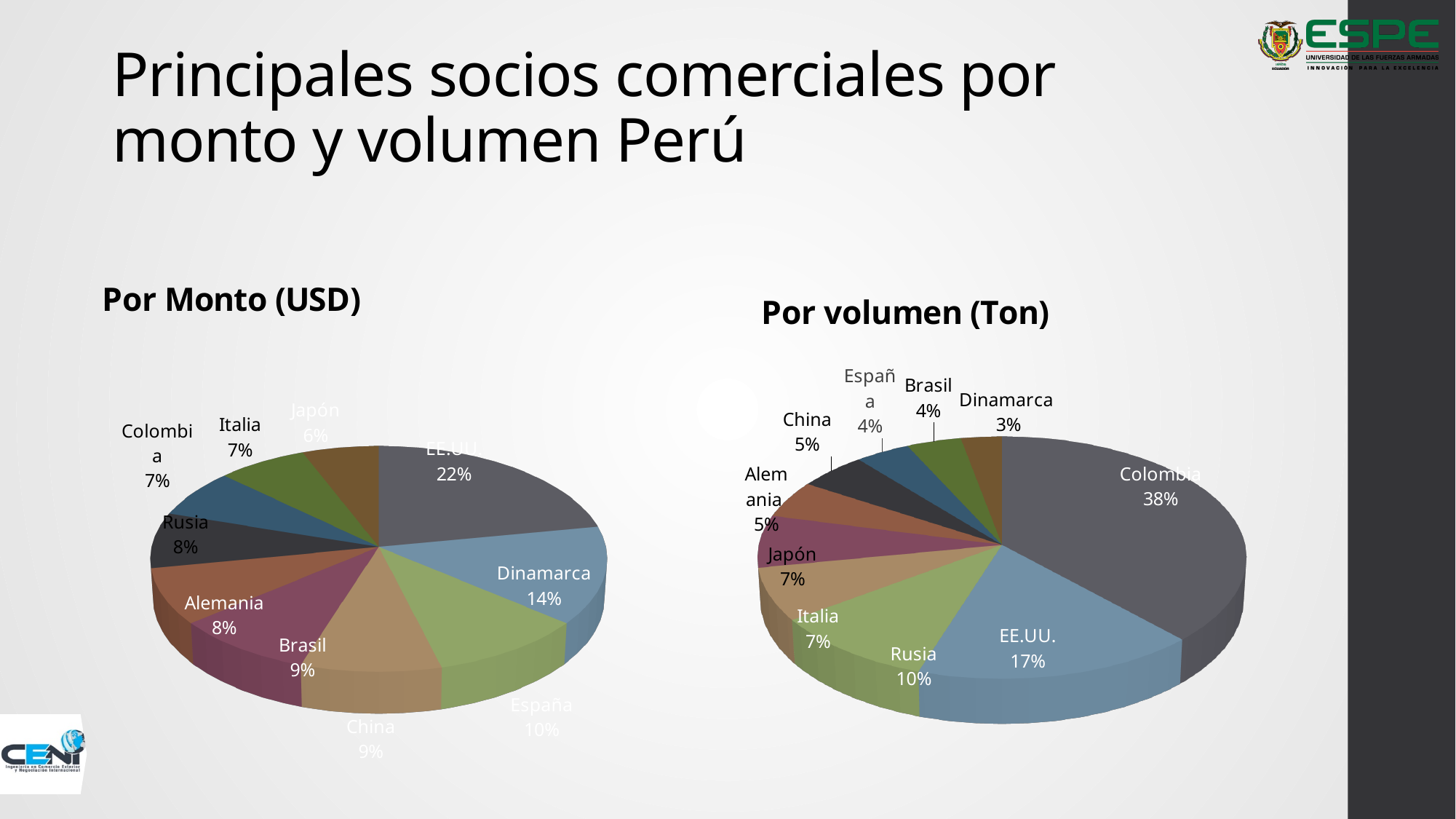
In the 'Por volumen (Ton)' chart, what is the difference between the shares of Colombia and EE.UU.? 21% In the 'Por Monto (USD)' chart, which country has the smallest share? Japón In the 'Por Monto (USD)' chart, which country has the largest share? EE.UU. In the 'Por volumen (Ton)' chart, what share does Rusia have? 10% In the 'Por Monto (USD)' chart, how many countries are shown? 10 In the 'Por volumen (Ton)' chart, what share does Colombia have? 38% In the 'Por volumen (Ton)' chart, which country has the smallest share? Dinamarca In the 'Por Monto (USD)' chart, what share does Dinamarca have? 14% What type of chart is used for 'Por volumen (Ton)'? Pie chart In the 'Por Monto (USD)' chart, what share does EE.UU. have? 22% What is the title of the chart on the left side of the slide? Por Monto (USD) In the 'Por volumen (Ton)' chart, which is larger, the share of Rusia or the share of Italia? Rusia